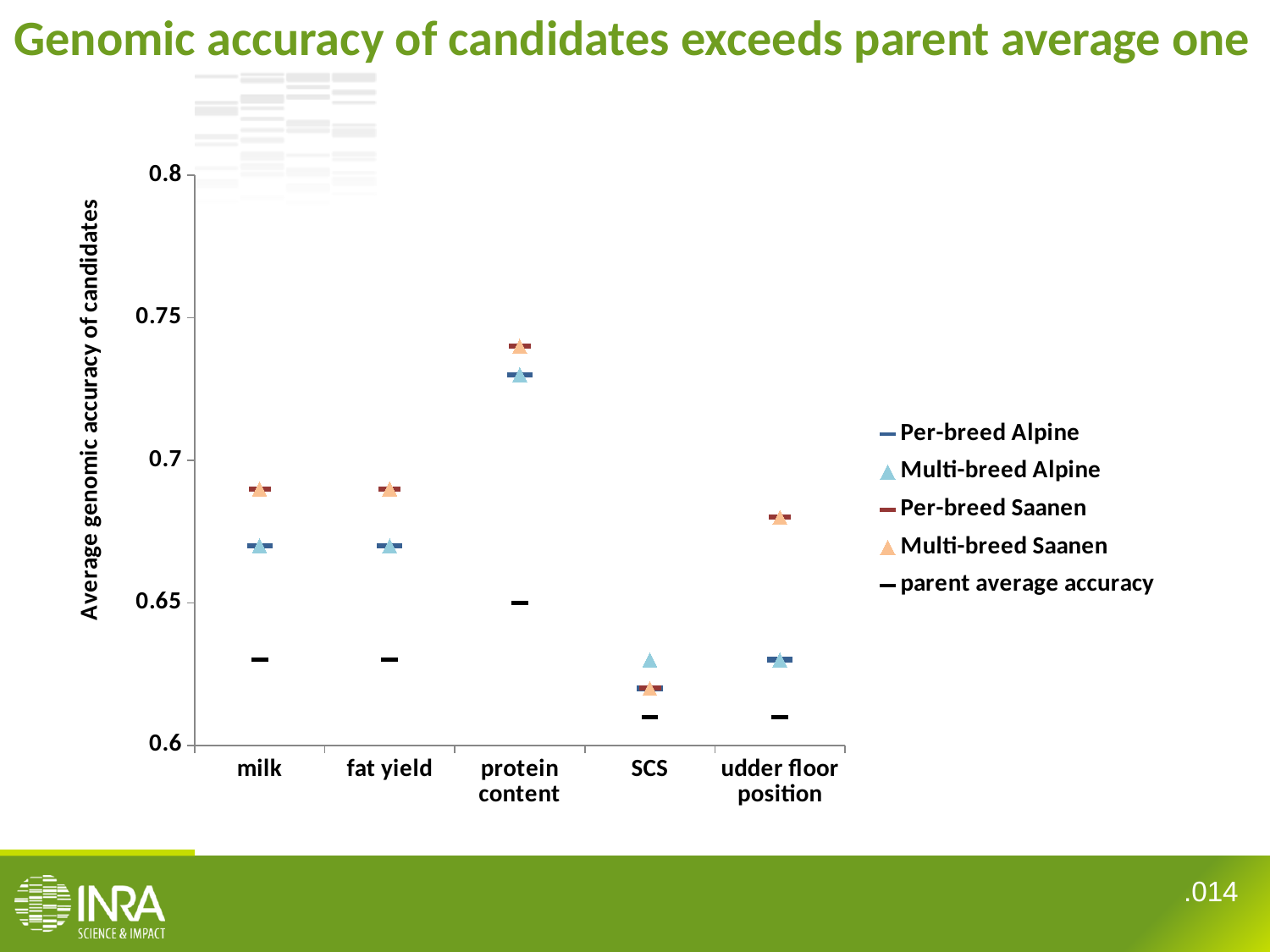
Which category has the highest parent average accuracy? protein content How many series does the legend list? 5 What is the title of the slide's chart? Genomic accuracy of candidates exceeds parent average one How many trait categories are shown on the x axis? 5 For protein content, which is larger: Multi-breed Alpine or parent average accuracy? Multi-breed Alpine For udder floor position, which is larger: Per-breed Saanen or Per-breed Alpine? Per-breed Saanen Is the Multi-breed Alpine value for milk greater or less than 0.7? less Is the parent average accuracy for milk greater or less than 0.65? less Is the Per-breed Saanen value for protein content greater or less than 0.7? greater What is the label of the y axis? Average genomic accuracy of candidates What kind of chart is shown on the slide? scatter chart Which category has the highest Per-breed Saanen accuracy? protein content